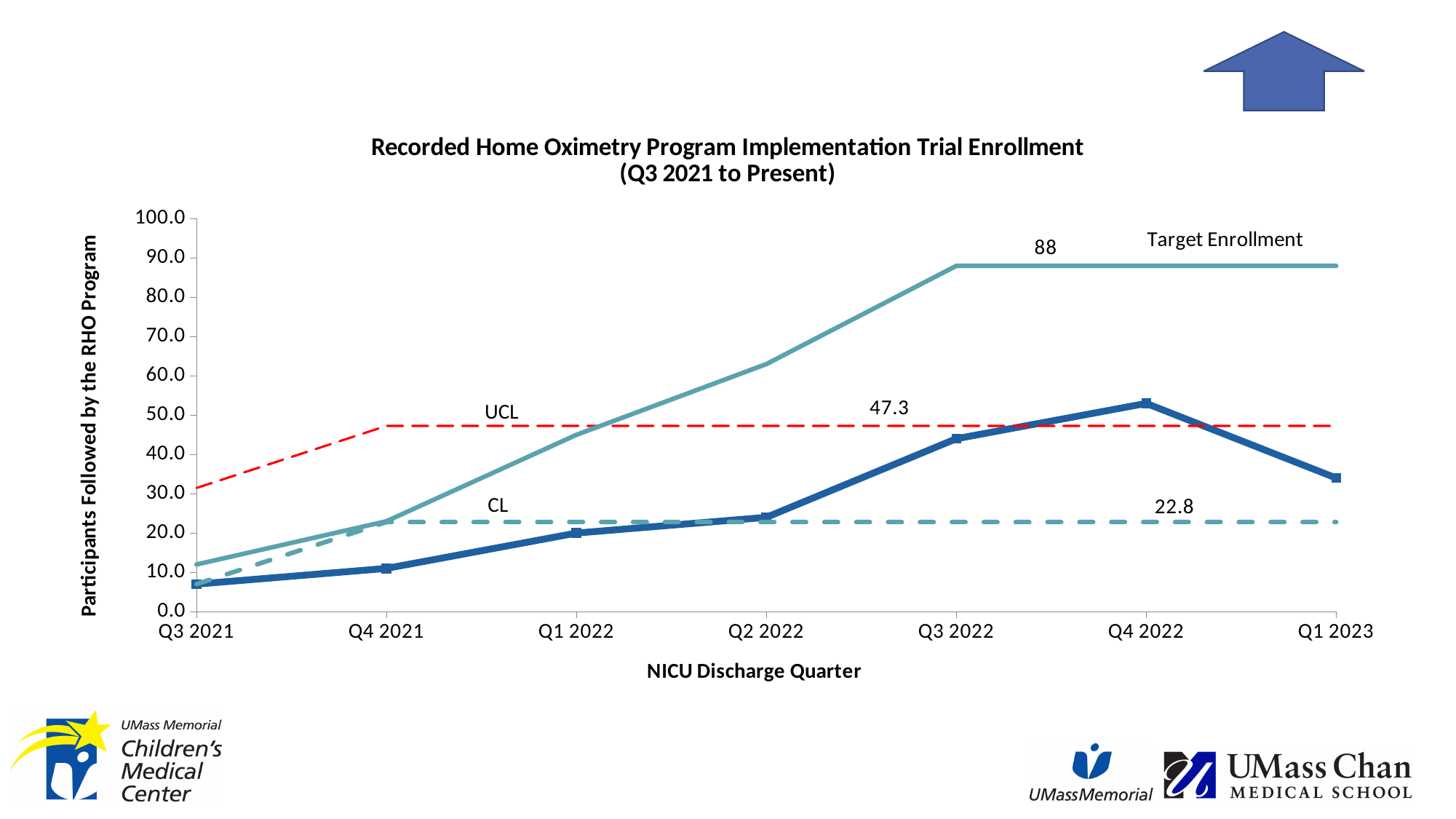
What is the value of the CL line? 22.8 What value does the Target Enrollment line reach at its plateau? 88 In which quarter is the dark blue participants line at its lowest value? Q3 2021 What is the value of the UCL line? 47.3 Is the value of the dark blue participants line at Q3 2022 greater or less than 50? less Which quarter has a higher value on the dark blue participants line, Q3 2022 or Q1 2023? Q3 2022 In which quarter does the dark blue participants line reach its highest value? Q4 2022 How many quarters are shown along the x axis? 7 What is the difference between the UCL value and the CL value? 24.5 What kind of chart is shown on the slide? line chart What is the difference between the Target Enrollment plateau value and the UCL value? 40.7 What is the label of the x axis? NICU Discharge Quarter